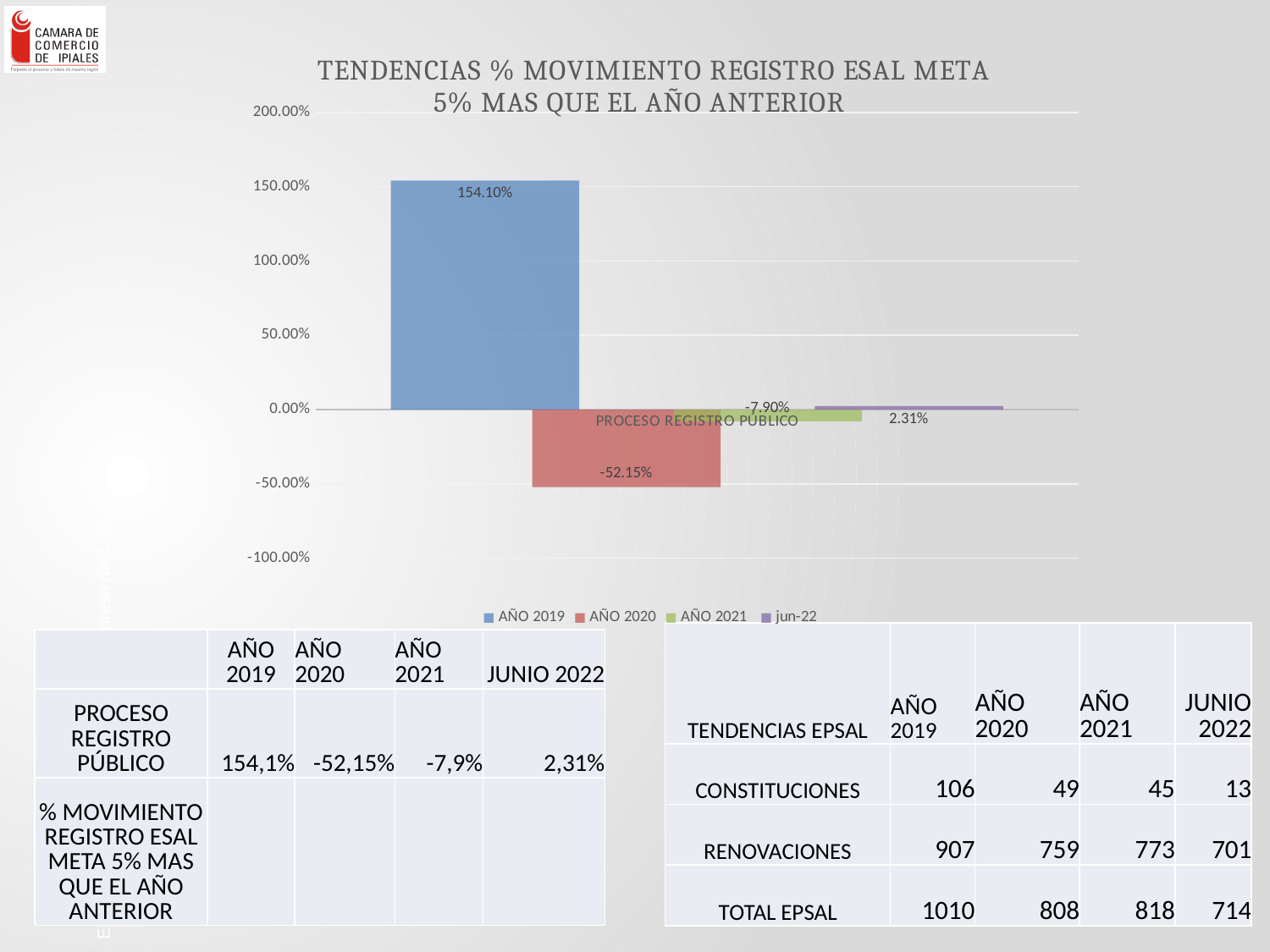
What is the value for AÑO 2020 in the chart? -52.15% Which series has the highest value in the chart? AÑO 2019 What colour is the bar for AÑO 2020 in the chart? red Which is larger in the chart, the value for AÑO 2021 or the value for jun-22? jun-22 What is the value for AÑO 2021 in the chart? -7.90% What kind of chart is shown on the slide? bar chart What is the category label shown on the x axis of the chart? PROCESO REGISTRO PÚBLICO How many series does the chart legend list? 4 Is the value for AÑO 2019 greater or less than 150.00%? greater Which series has the lowest value in the chart? AÑO 2020 What is the value for jun-22 in the chart? 2.31% What is the value for AÑO 2019 in the chart? 154.10%